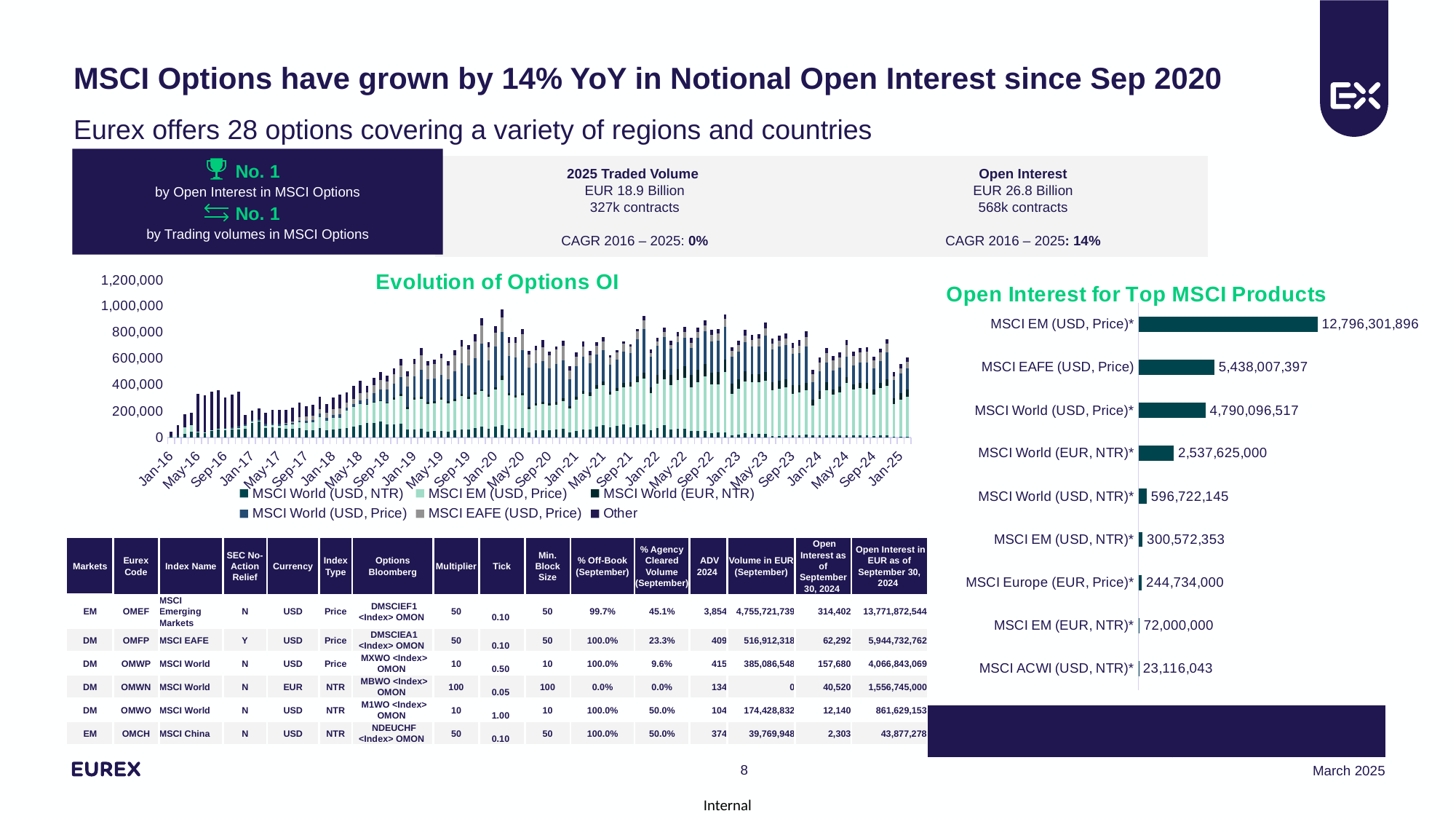
In the 'Open Interest for Top MSCI Products' chart, what is the value for MSCI ACWI (USD, NTR)*? 23,116,043 In the 'Evolution of Options OI' chart, is the tallest bar greater or less than 800,000? greater In the 'Evolution of Options OI' chart, is the total for Jan-16 greater or less than 200,000? less In the 'Open Interest for Top MSCI Products' chart, what is the value for MSCI EM (USD, Price)*? 12,796,301,896 In the 'Open Interest for Top MSCI Products' chart, which product has the highest open interest? MSCI EM (USD, Price)* How many products are shown in the 'Open Interest for Top MSCI Products' chart? 9 In the 'Open Interest for Top MSCI Products' chart, which product has the lowest open interest? MSCI ACWI (USD, NTR)* How many series does the legend of the 'Evolution of Options OI' chart list? 6 In the 'Open Interest for Top MSCI Products' chart, what is the value for MSCI World (EUR, NTR)*? 2,537,625,000 In the 'Open Interest for Top MSCI Products' chart, which is larger: MSCI World (USD, Price)* or MSCI EAFE (USD, Price)? MSCI EAFE (USD, Price) In the 'Open Interest for Top MSCI Products' chart, what is the difference between MSCI EM (USD, Price)* and MSCI EAFE (USD, Price)? 7,358,294,499 What kind of chart is 'Open Interest for Top MSCI Products'? Bar chart